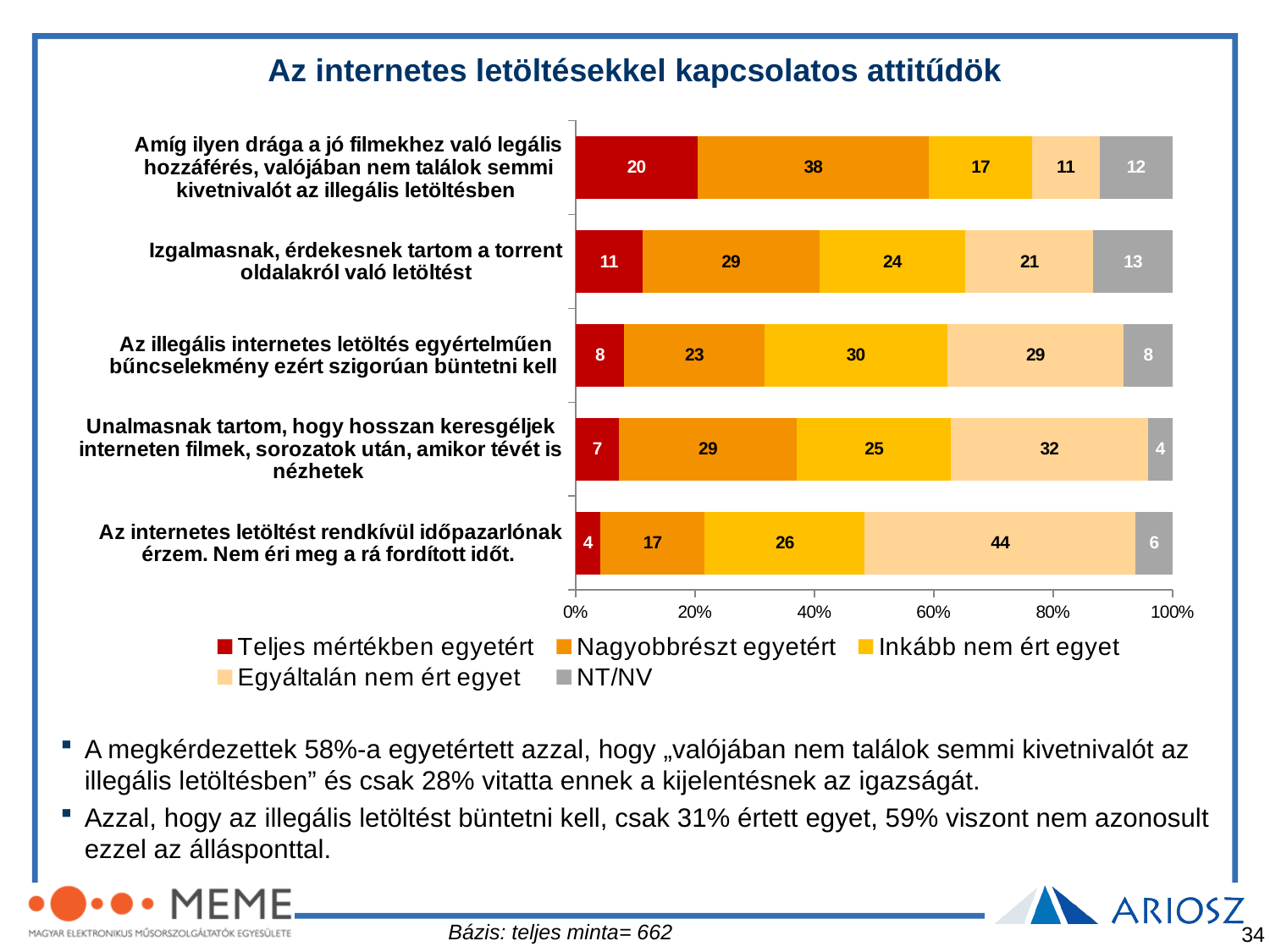
What is the 'Egyáltalán nem ért egyet' value for the statement 'Az internetes letöltést rendkívül időpazarlónak érzem. Nem éri meg a rá fordított időt.'? 44 Which colour represents the 'NT/NV' series in the chart? Grey Which statement has the highest 'Teljes mértékben egyetért' value? Amíg ilyen drága a jó filmekhez való legális hozzáférés, valójában nem találok semmi kivetnivalót az illegális letöltésben What is the difference between the 'Egyáltalán nem ért egyet' values for 'Az internetes letöltést rendkívül időpazarlónak érzem...' (44) and 'Unalmasnak tartom, hogy hosszan keresgéljek...' (32)? 12 Which is larger: the 'Inkább nem ért egyet' value for 'Az illegális internetes letöltés egyértelműen bűncselekmény...' or for 'Izgalmasnak, érdekesnek tartom a torrent oldalakról való letöltést'? Az illegális internetes letöltés egyértelműen bűncselekmény ezért szigorúan büntetni kell What is the 'Teljes mértékben egyetért' value for the statement 'Izgalmasnak, érdekesnek tartom a torrent oldalakról való letöltést'? 11 Which statement has the lowest 'NT/NV' value? Unalmasnak tartom, hogy hosszan keresgéljek interneten filmek, sorozatok után, amikor tévét is nézhetek How many statements (categories) are plotted in the chart? 5 What kind of chart is shown on the slide? Stacked bar chart How many series does the legend list? 5 What is the total of the printed segment values for the statement 'Az illegális internetes letöltés egyértelműen bűncselekmény ezért szigorúan büntetni kell'? 98 What is the 'Nagyobbrészt egyetért' value for the statement 'Amíg ilyen drága a jó filmekhez való legális hozzáférés, valójában nem találok semmi kivetnivalót az illegális letöltésben'? 38